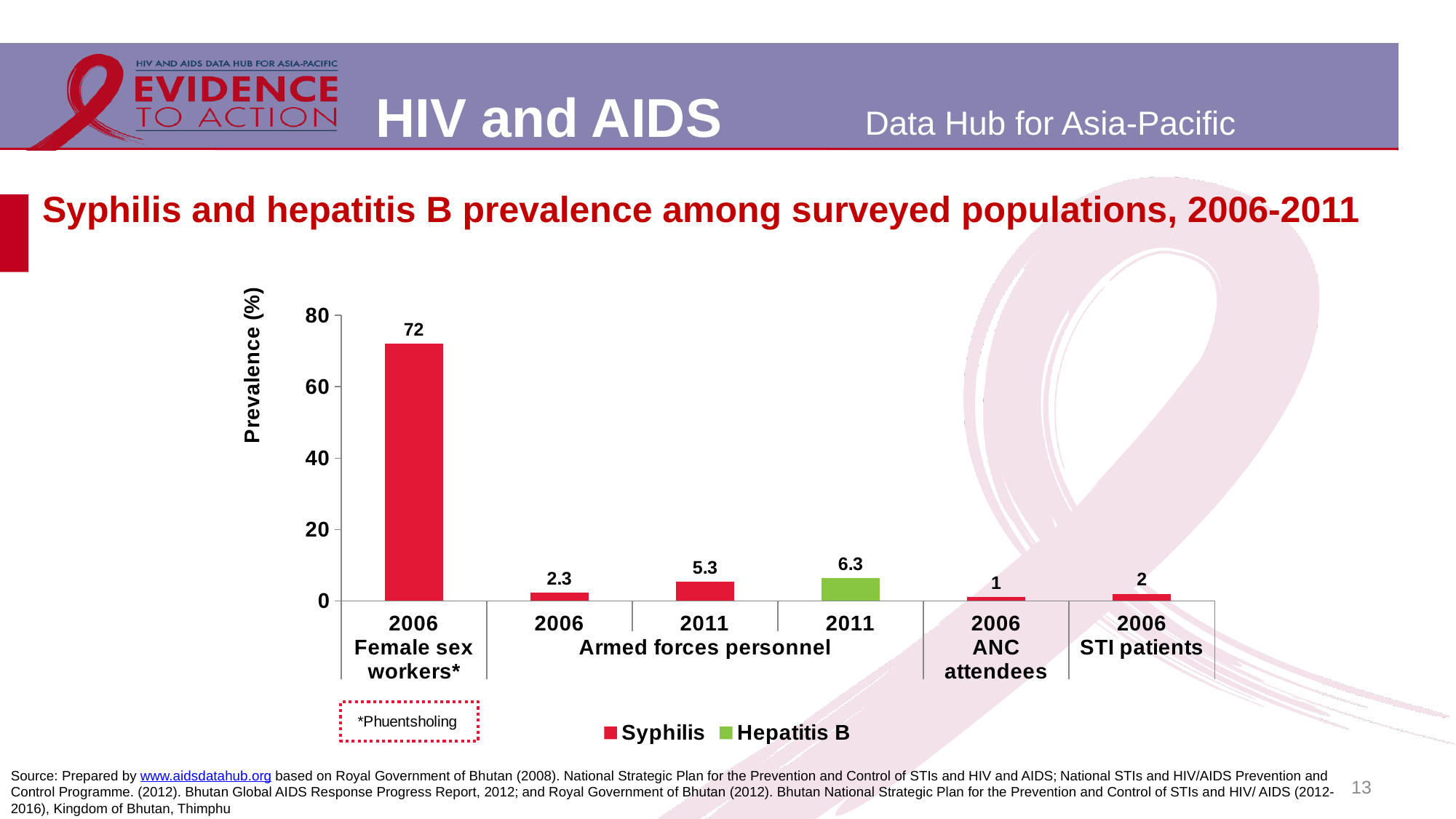
What is the syphilis prevalence among STI patients in 2006? 2 What is the syphilis prevalence among armed forces personnel in 2011? 5.3 What does the asterisk next to 'Female sex workers' refer to? Phuentsholing Which bar shows the lowest prevalence on the chart? ANC attendees (2006) What is the syphilis prevalence among ANC attendees in 2006? 1 Which is larger for armed forces personnel in 2011: syphilis prevalence or hepatitis B prevalence? Hepatitis B What is the syphilis prevalence among female sex workers in 2006? 72 How many series does the legend list? 2 What is the hepatitis B prevalence among armed forces personnel in 2011? 6.3 Which surveyed population has the highest prevalence shown on the chart? Female sex workers (2006) What kind of chart is shown on the slide? Bar chart What is the difference between the syphilis prevalence among armed forces personnel in 2011 and in 2006? 3